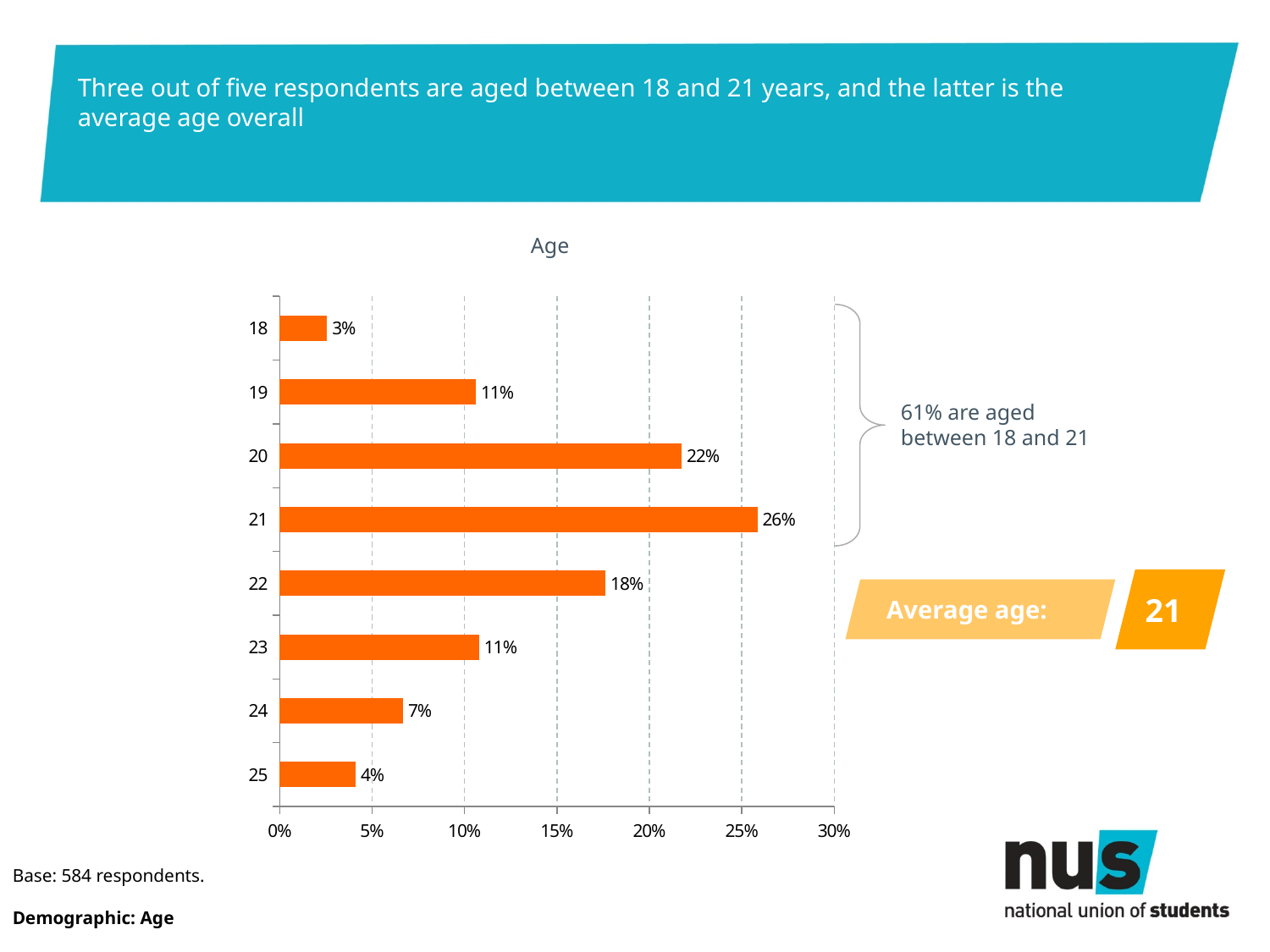
How many age categories are shown in the chart? 8 What is the combined percentage of respondents aged 24 and 25? 11% What percentage of respondents are aged 22? 18% Is the value for age 20 greater or less than 20%? greater Which age has the highest percentage of respondents? 21 Which has a larger share of respondents, age 19 or age 24? 19 Which age has the lowest percentage of respondents? 18 What percentage of respondents are aged 18? 3% What percentage of respondents are aged 21? 26% What is the title of the chart? Age What is the difference in percentage points between respondents aged 21 and those aged 20? 4% What kind of chart is used to show the age distribution? bar chart